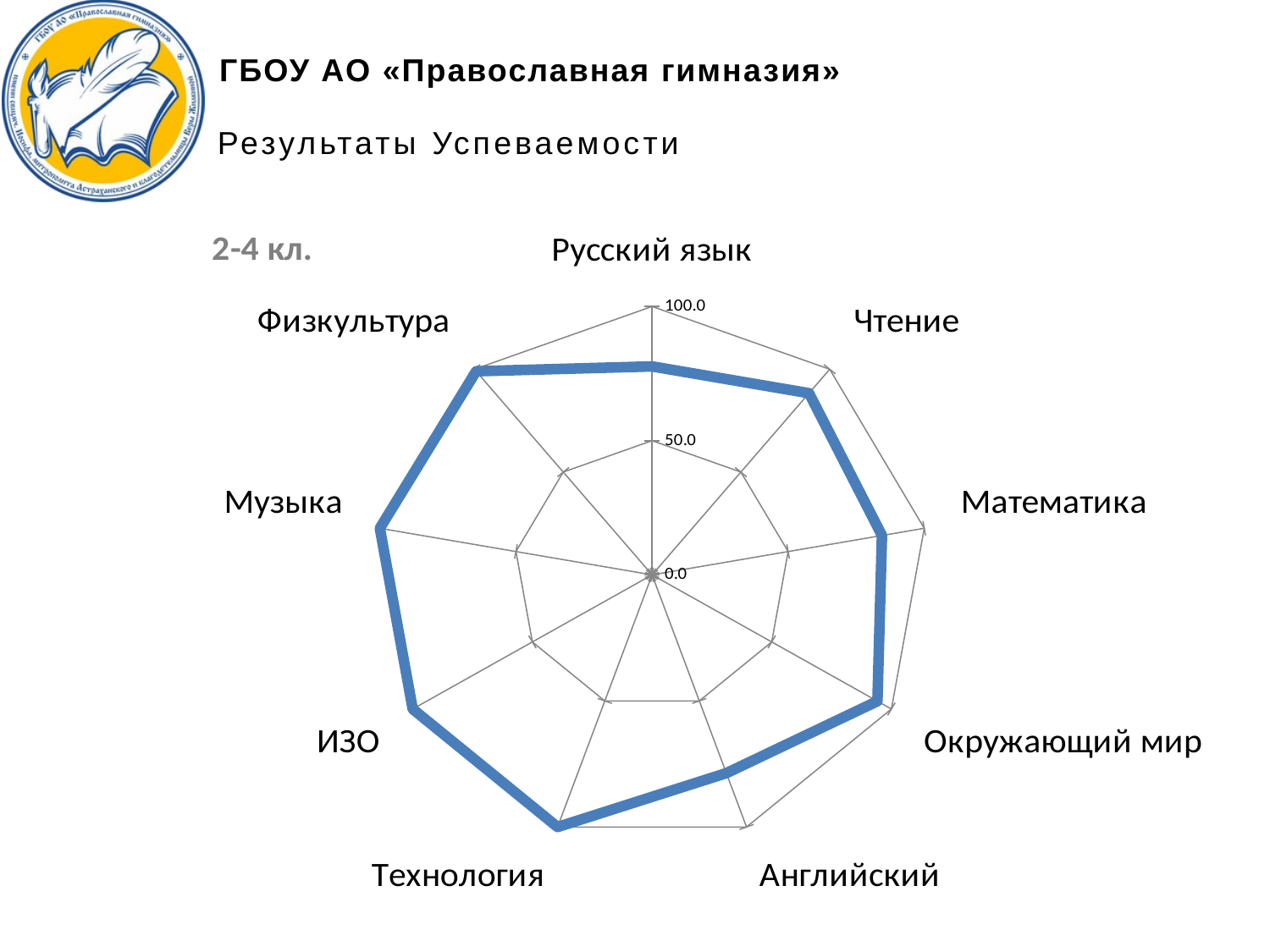
Which is larger, the value for Технология or the value for Английский? Технология Is the value for Математика greater or less than 50? greater What class range label is shown above the chart? 2-4 кл. Is the value for Английский greater or less than 50? greater How many subject categories are plotted on the radar chart? 9 Is the value for Русский язык greater or less than 50? greater What kind of chart is shown on the slide? radar chart Which is larger, the value for Музыка or the value for Русский язык? Музыка Which is larger, the value for ИЗО or the value for Русский язык? ИЗО What is the maximum value shown on the radar chart's axis scale? 100.0